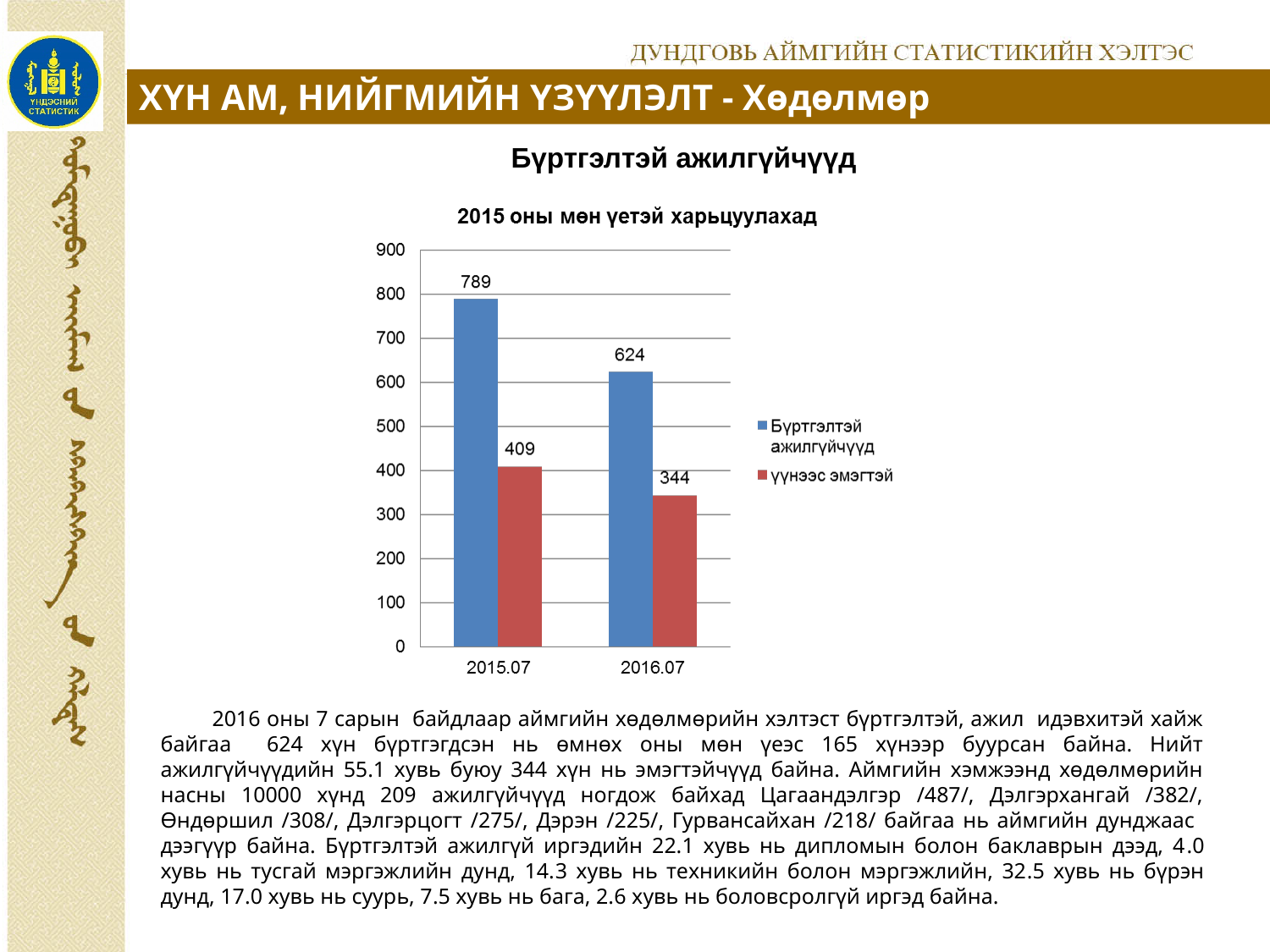
What is the value for үүнээс эмэгтэй in 2016.07? 344 What kind of chart is shown on the slide? Bar chart What is the difference between the Бүртгэлтэй ажилгүйчүүд values for 2015.07 and 2016.07? 165 What is the value for Бүртгэлтэй ажилгүйчүүд in 2016.07? 624 What is the difference between the үүнээс эмэгтэй values for 2015.07 and 2016.07? 65 How many categories are shown on the x axis? 2 Which category has the highest value for Бүртгэлтэй ажилгүйчүүд? 2015.07 How many series does the legend list? 2 Which is larger: Бүртгэлтэй ажилгүйчүүд in 2016.07 or үүнээс эмэгтэй in 2015.07? Бүртгэлтэй ажилгүйчүүд in 2016.07 What is the value for үүнээс эмэгтэй in 2015.07? 409 What is the value for Бүртгэлтэй ажилгүйчүүд in 2015.07? 789 Which category has the lowest value for үүнээс эмэгтэй? 2016.07